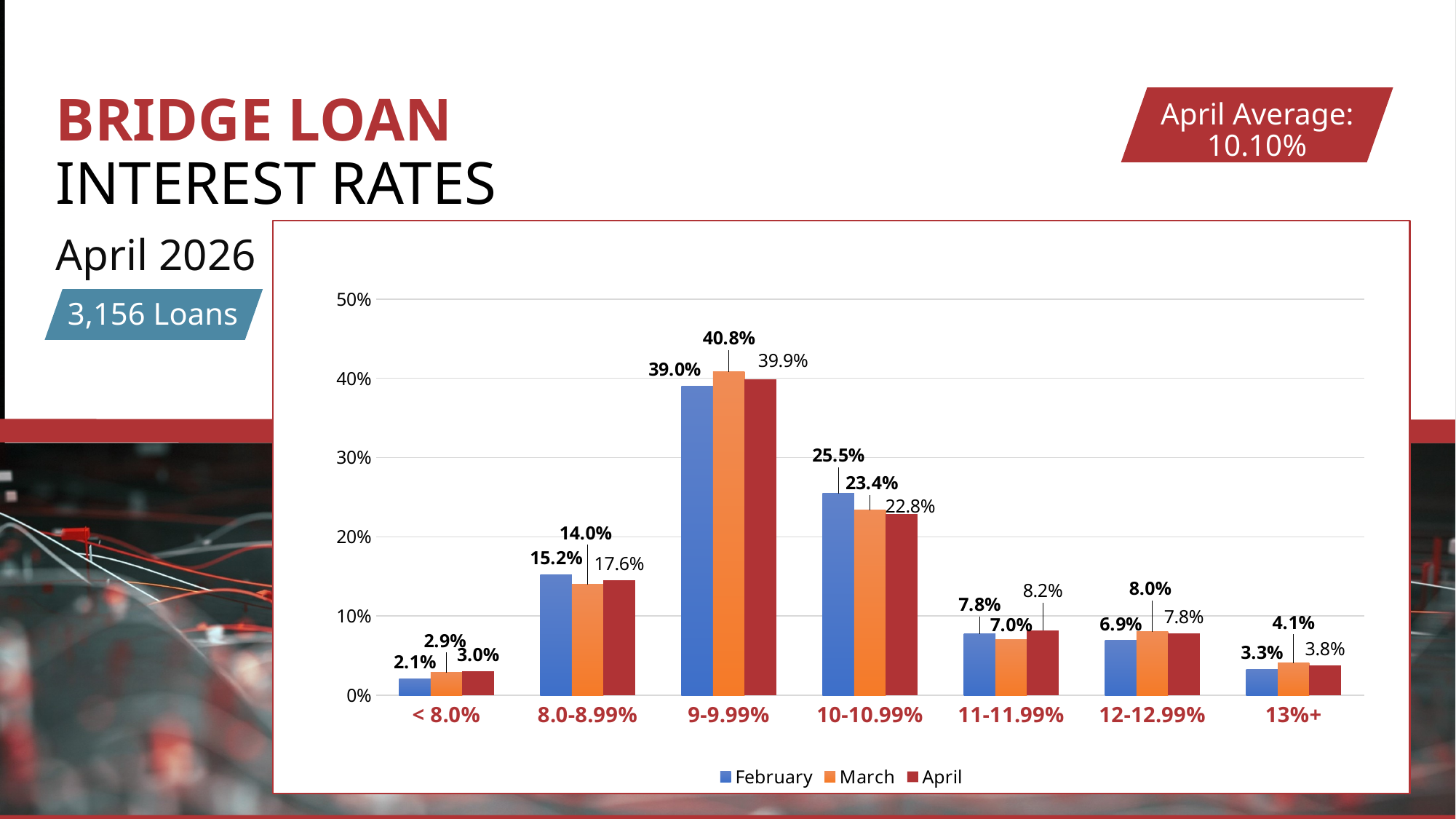
How many series does the legend list? 3 What is the difference between the February and March values for the 10-10.99% category? 2.1% What is the March value for the 12-12.99% category? 8.0% Which is larger for the 13%+ category, the March value or the April value? March Which category has the highest March value? 9-9.99% Is the February value for the 9-9.99% category greater or less than 30%? greater How many interest rate categories are shown on the x axis? 7 What kind of chart is shown on the slide? bar chart Which series is shown in orange in the legend? March What is the April value for the 9-9.99% category? 39.9% Which category has the lowest February value? < 8.0% What is the February value for the 10-10.99% category? 25.5%